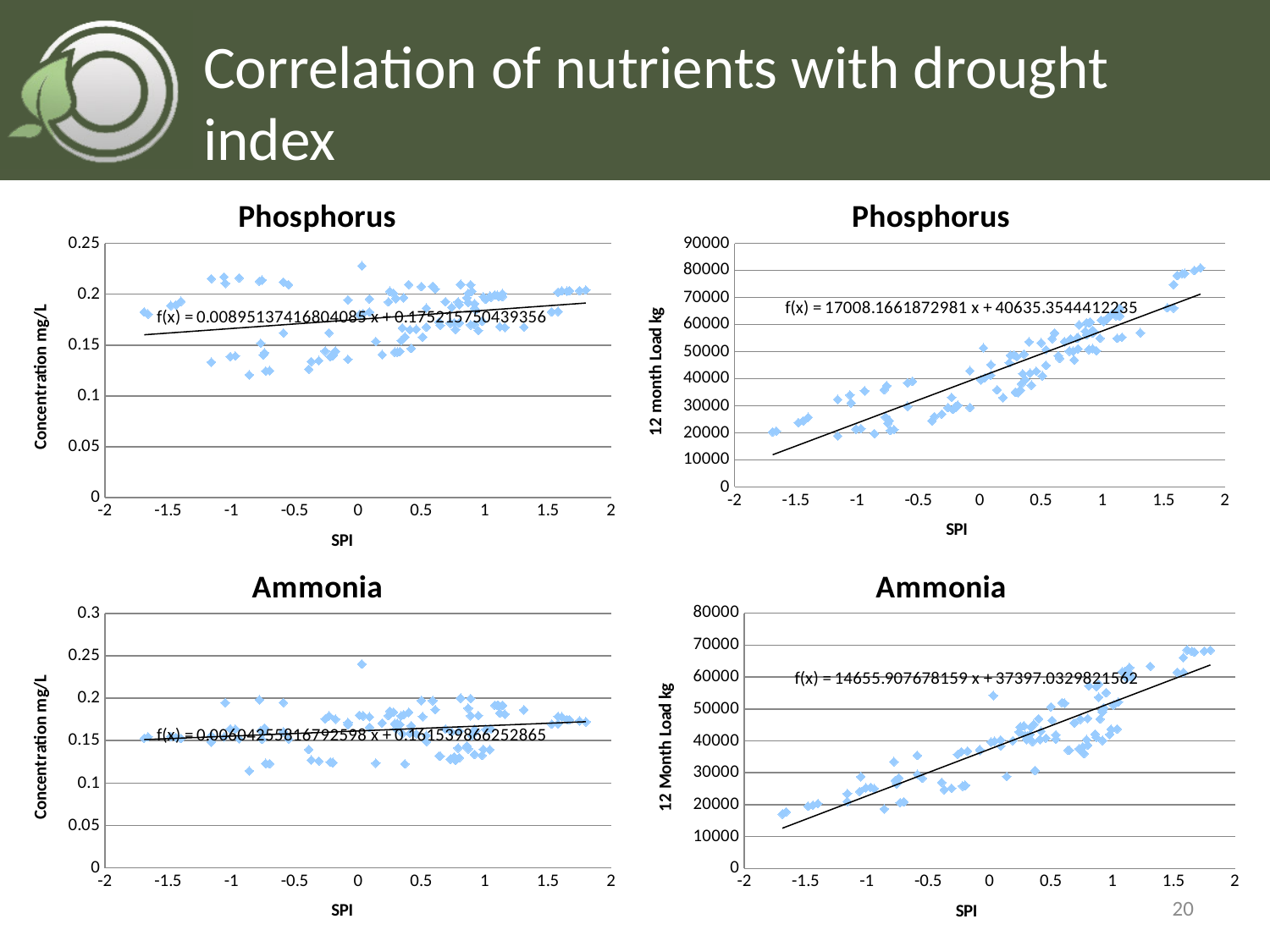
What is the trendline equation shown on the bottom-right Ammonia chart? f(x) = 14655.907678159 x + 37397.0329821562 In the bottom-right Ammonia chart, is the lowest plotted load value greater or less than 20000? less What is the x-axis title shared by all four charts? SPI What is the trendline equation shown on the bottom-left Ammonia concentration chart? f(x) = 0.00604255816792598 x + 0.161539866252865 What is the trendline equation shown on the top-right Phosphorus chart? f(x) = 17008.1661872981 x + 40635.3544412235 In the top-right Phosphorus chart (12 month Load kg), do the values generally rise or fall as SPI increases? rise In the bottom-right Ammonia chart (12 Month Load kg), do the values generally rise or fall as SPI increases? rise What is the trendline equation shown on the top-left Phosphorus concentration chart? f(x) = 0.00895137416804085 x + 0.175215750439356 What is the y-axis title of the top-right Phosphorus chart? 12 month Load kg What kind of chart is the top-left Phosphorus chart? scatter chart In the top-right Phosphorus chart, is the highest plotted load value greater or less than 70000? greater In the bottom-left Ammonia concentration chart, is the highest plotted point greater or less than 0.2 mg/L? greater